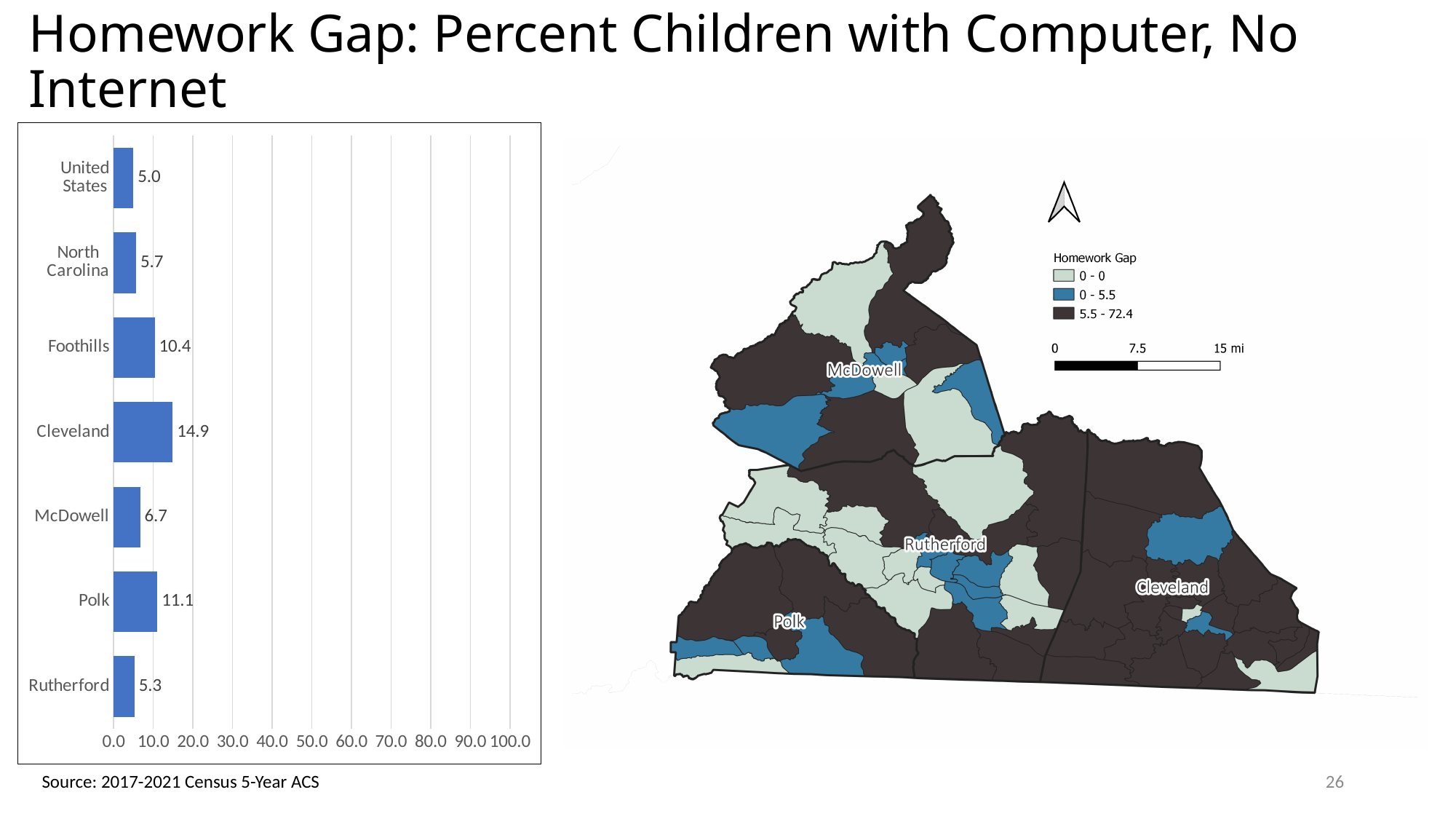
What is the value for Cleveland in the bar chart? 14.9 Is the value for Foothills in the bar chart greater or less than 10.0? greater Which category has the lowest value in the bar chart? United States What is the difference between the values for Cleveland and Rutherford in the bar chart? 9.6 What kind of chart is shown on the left of the slide? bar chart Which category has the highest value in the bar chart? Cleveland What is the maximum value shown on the x axis of the bar chart? 100.0 What is the difference between the values for Foothills and North Carolina in the bar chart? 4.7 What is the value for the United States in the bar chart? 5.0 Which has a larger value in the bar chart, Polk or McDowell? Polk How many categories are shown in the bar chart? 7 What is the value for Polk in the bar chart? 11.1